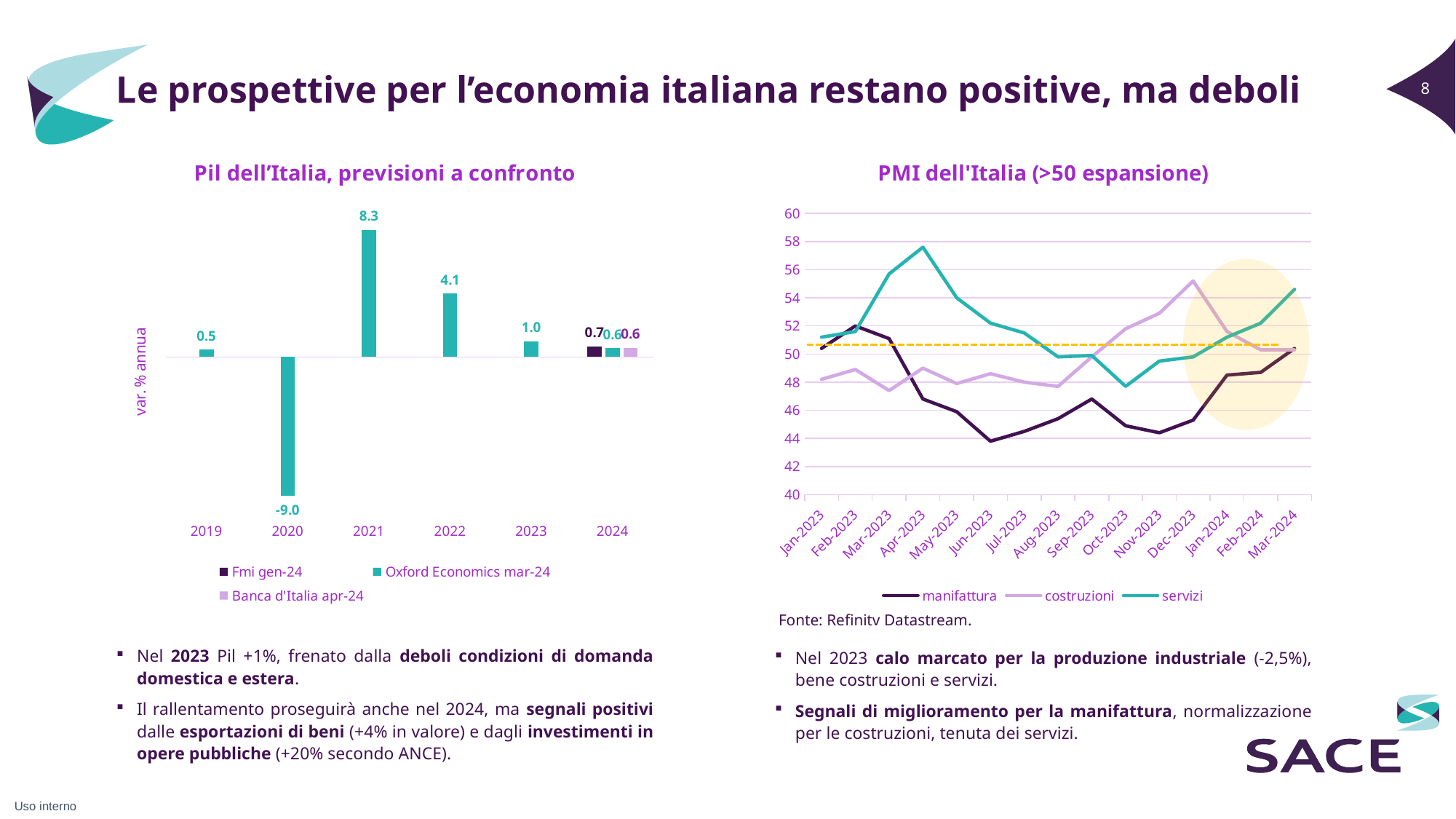
In the chart 'Pil dell'Italia, previsioni a confronto', which is larger: the value for 2019 or the value for 2023? 2023 What kind of chart is 'Pil dell'Italia, previsioni a confronto'? bar chart In the chart 'PMI dell'Italia (>50 espansione)', is the value for manifattura in Jun-2023 greater or less than 46? less In the chart 'PMI dell'Italia (>50 espansione)', is the value for servizi in Apr-2023 greater or less than 56? greater In the chart 'Pil dell'Italia, previsioni a confronto', what is the difference between the 2021 and 2022 values? 4.2 In the chart 'Pil dell'Italia, previsioni a confronto', what is the Fmi gen-24 forecast for 2024? 0.7 How many months are shown on the x axis of the chart 'PMI dell'Italia (>50 espansione)'? 15 What kind of chart is 'PMI dell'Italia (>50 espansione)'? line chart In the chart 'Pil dell'Italia, previsioni a confronto', which year has the highest value? 2021 In the chart 'Pil dell'Italia, previsioni a confronto', which year has the lowest value? 2020 How many series does the legend of the chart 'Pil dell'Italia, previsioni a confronto' list? 3 In the chart 'Pil dell'Italia, previsioni a confronto', what is the value for 2021? 8.3